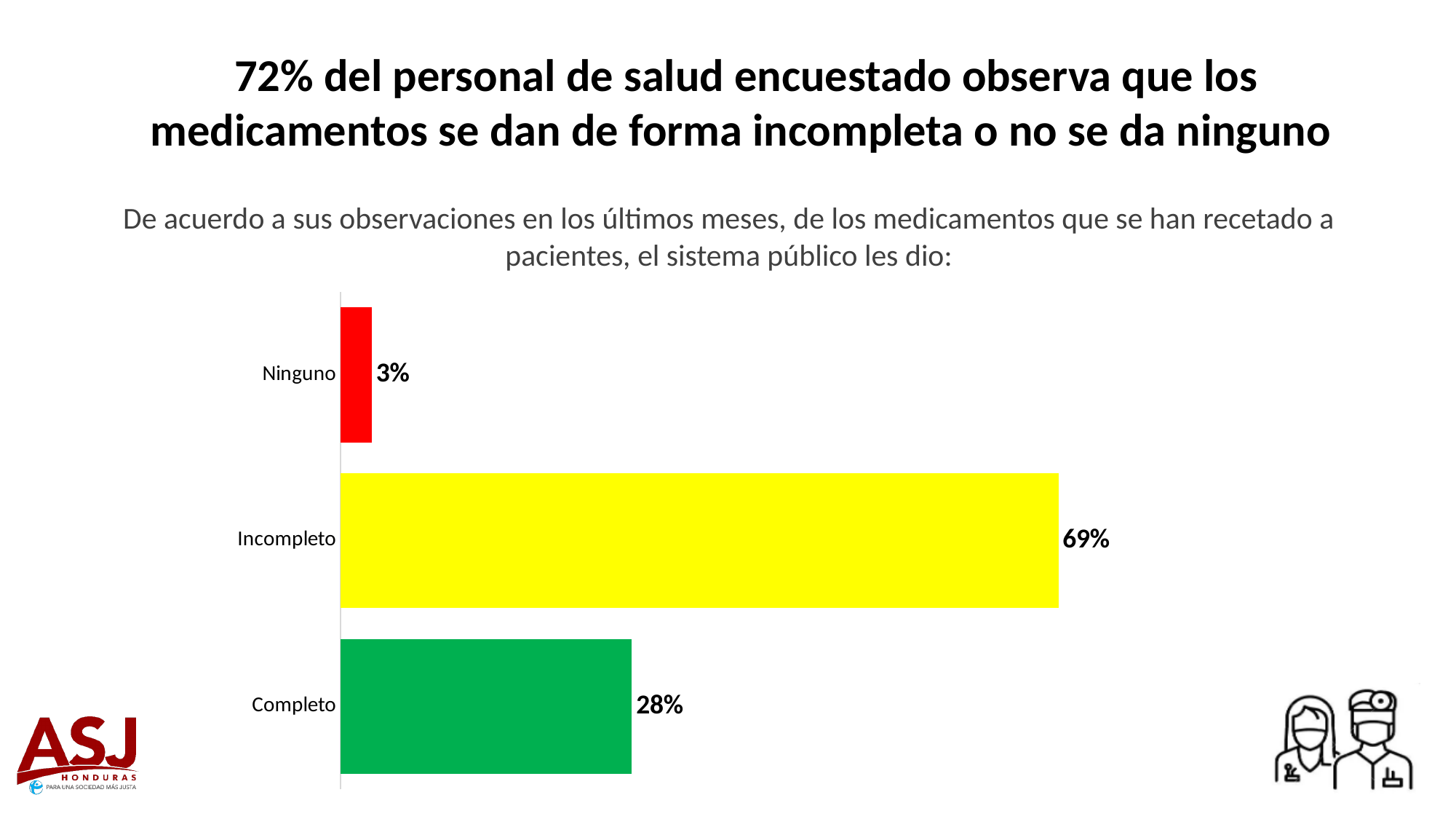
Which category has the lowest value? Ninguno What is the value for Completo? 28% What colour is the bar for Ninguno? Red What is the value for Ninguno? 3% What is the difference between the values for Incompleto and Completo? 41% How many categories are shown in the chart? 3 What is the difference between the values for Completo and Ninguno? 25% What kind of chart is shown on the slide? Bar chart What colour is the bar for Incompleto? Yellow Which category has the highest value? Incompleto Which is larger, the value for Completo or the value for Ninguno? Completo What is the value for Incompleto? 69%